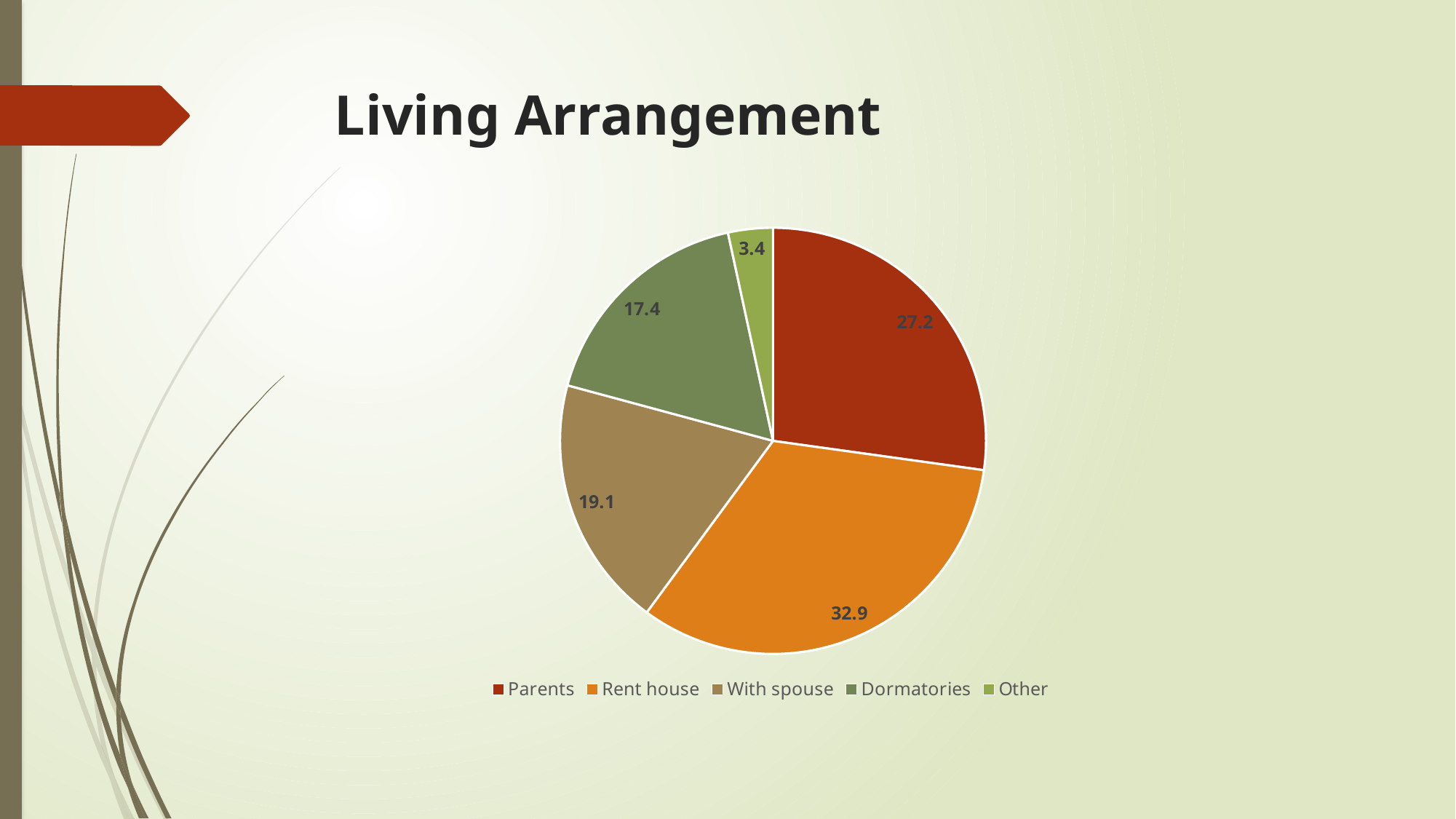
What type of chart is shown on the slide? pie chart Which is larger, the value for With spouse or the value for Dormatories? With spouse Which category has the smallest slice? Other Which category has the largest slice? Rent house What is the difference between the values for Rent house and Parents? 5.7 How many categories does the pie chart have? 5 What is the value for With spouse? 19.1 What is the title of the slide containing the chart? Living Arrangement What is the value for Dormatories? 17.4 What is the value for Other? 3.4 What is the value for Rent house? 32.9 What is the value for Parents? 27.2